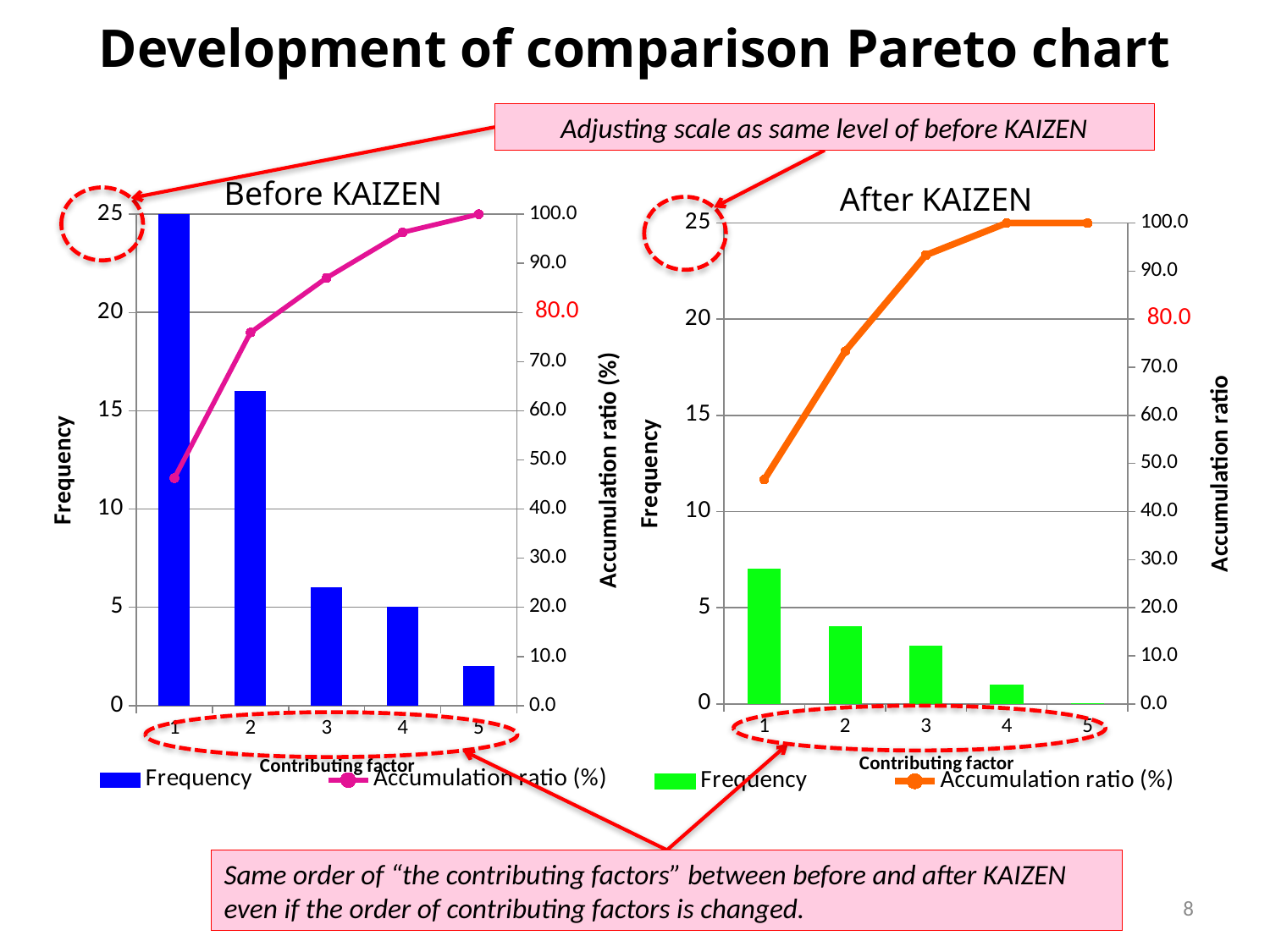
In the Before KAIZEN chart, which contributing factor has the highest frequency? 1 In the Before KAIZEN chart, is the frequency for contributing factor 2 greater or less than 15? greater In the After KAIZEN chart, does the frequency rise or fall from contributing factor 1 to contributing factor 5? Fall How many series does the legend of the Before KAIZEN chart list? 2 In the After KAIZEN chart, which contributing factor has the highest frequency? 1 In the Before KAIZEN chart, is the frequency for contributing factor 1 larger than the frequency for contributing factor 1 in the After KAIZEN chart? Yes In the After KAIZEN chart, what is the accumulation ratio (%) at contributing factor 5? 100.0 In the After KAIZEN chart, is the frequency for contributing factor 1 greater or less than 10? less In the Before KAIZEN chart, what is the accumulation ratio (%) at contributing factor 5? 100.0 In the Before KAIZEN chart, what is the frequency for contributing factor 4? 5 In the Before KAIZEN chart, what is the frequency for contributing factor 1? 25 How many contributing factors are shown on the x axis of the After KAIZEN chart? 5